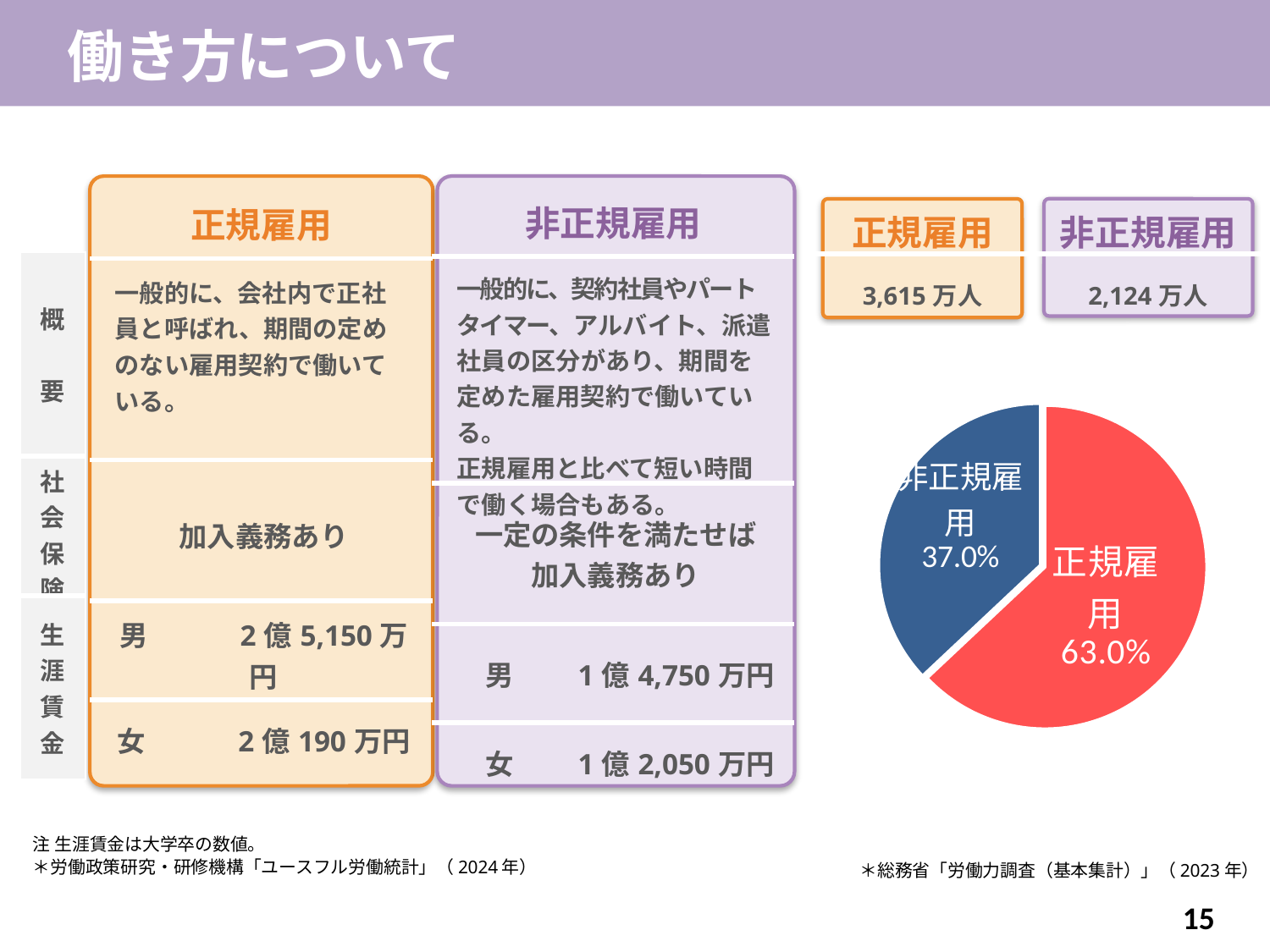
In the pie chart, which is larger: 正規雇用 or 非正規雇用? 正規雇用 What colour is the 正規雇用 slice in the pie chart? Red In the pie chart, what share is labelled for 正規雇用? 63.0% In the pie chart, what is the difference in percentage points between 正規雇用 and 非正規雇用? 26.0 percentage points Is the share for 非正規雇用 in the pie chart greater or less than 50%? less Which slice of the pie chart is the smallest? 非正規雇用 Which slice of the pie chart is the largest? 正規雇用 What colour is the 非正規雇用 slice in the pie chart? Blue In the pie chart, what share is labelled for 非正規雇用? 37.0% What kind of chart is shown on the right side of the slide? Pie chart How many slices does the pie chart have? 2